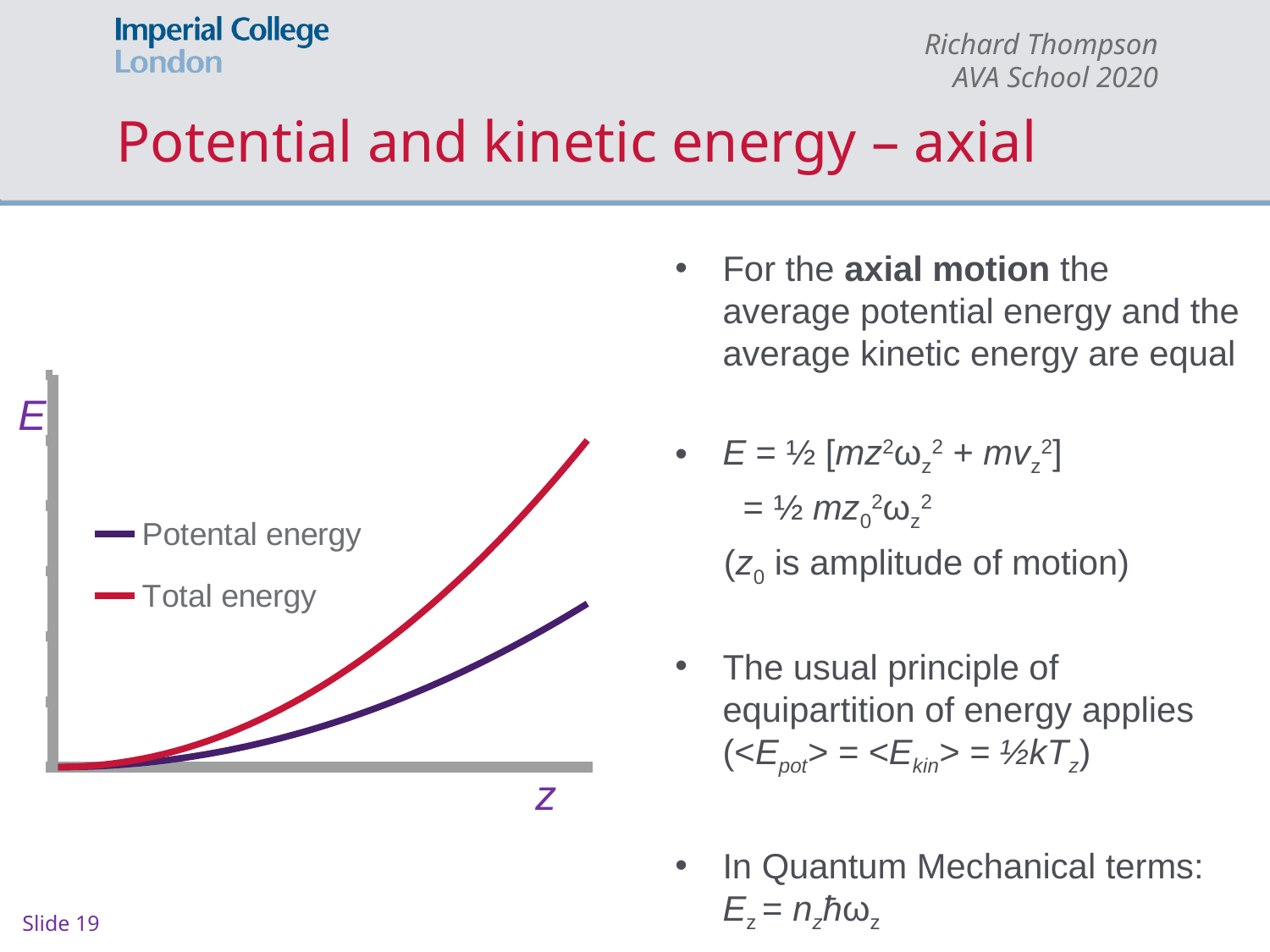
Which series reaches the highest value on the chart? Total energy Does the Potential energy curve rise or fall as z increases? Rises At the right-hand end of the chart, which curve is higher: Total energy or Potential energy? Total energy What kind of chart is shown on the slide? Line chart Does the Total energy curve rise or fall as z increases? Rises How many series does the chart's legend list? 2 What is the label of the horizontal axis of the chart? z What is the label of the vertical axis of the chart? E Which series has the lower value at the right-hand end of the chart? Potential energy